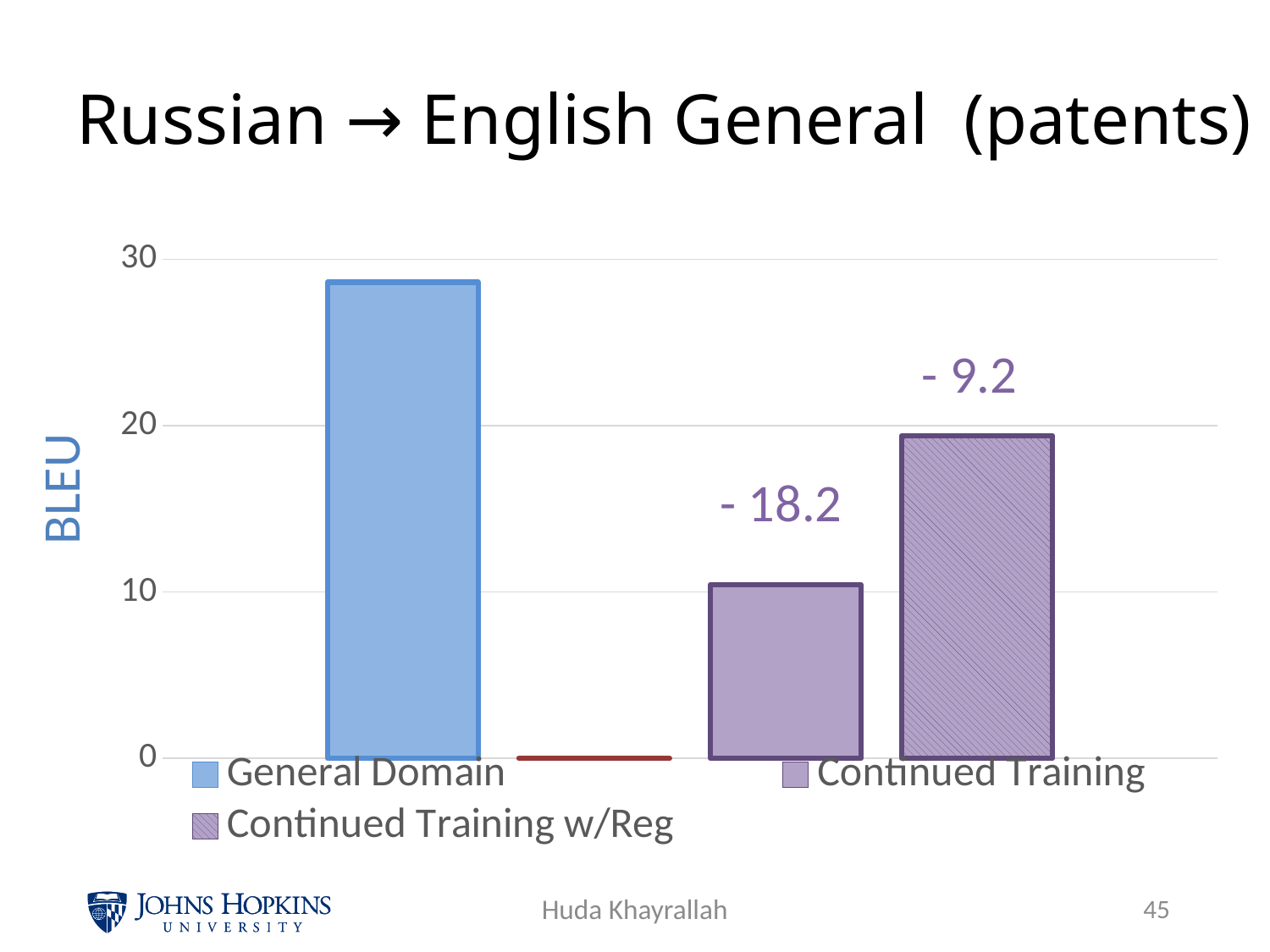
Which series has the highest BLEU score? General Domain Is the BLEU value for Continued Training greater or less than 20? less Of the three series listed in the legend, which has the lowest BLEU score? Continued Training Which has a higher BLEU score, General Domain or Continued Training w/Reg? General Domain How many series does the legend list? 3 Is the BLEU value for Continued Training w/Reg greater or less than 10? greater What annotation is printed above the Continued Training bar? - 18.2 What kind of chart is shown on the slide? bar chart Which has a higher BLEU score, Continued Training or Continued Training w/Reg? Continued Training w/Reg What annotation is printed above the Continued Training w/Reg bar? - 9.2 Is the BLEU value for General Domain greater or less than 20? greater